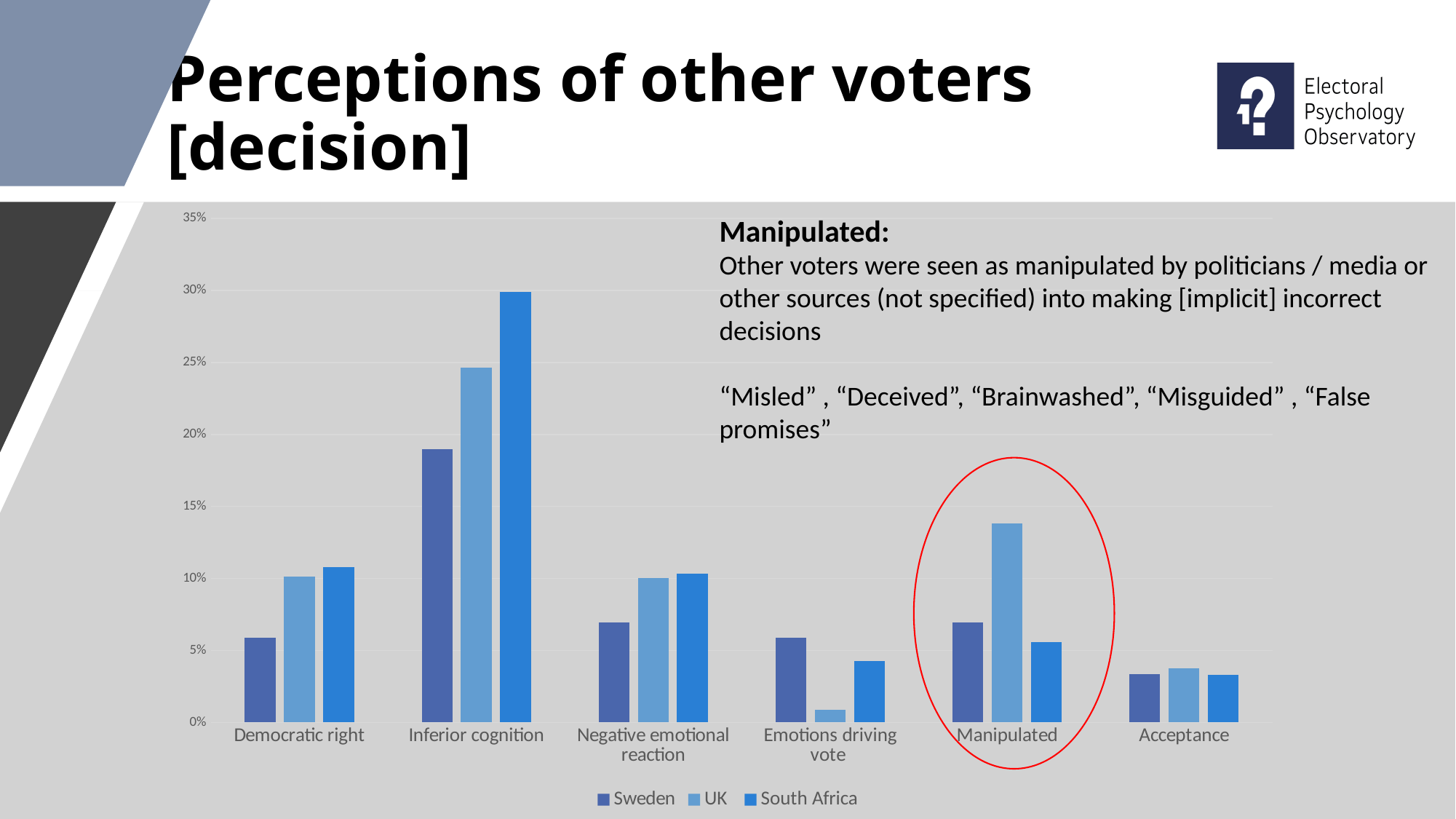
Is the South Africa value for Inferior cognition greater or less than 25%? greater For the Democratic right category, which is larger: the UK value or the Sweden value? UK For the Manipulated category, which country has the highest bar? UK What kind of chart is shown on the slide? bar chart Which category on the chart is circled in red? Manipulated Which category has the highest South Africa bar? Inferior cognition Is the Sweden value for Inferior cognition greater or less than 20%? less How many categories are shown on the x axis? 6 Is the UK value for Manipulated greater or less than 10%? greater For the Emotions driving vote category, which country has the lowest bar? UK For the Manipulated category, which is larger: the UK value or the Sweden value? UK How many series does the legend list? 3